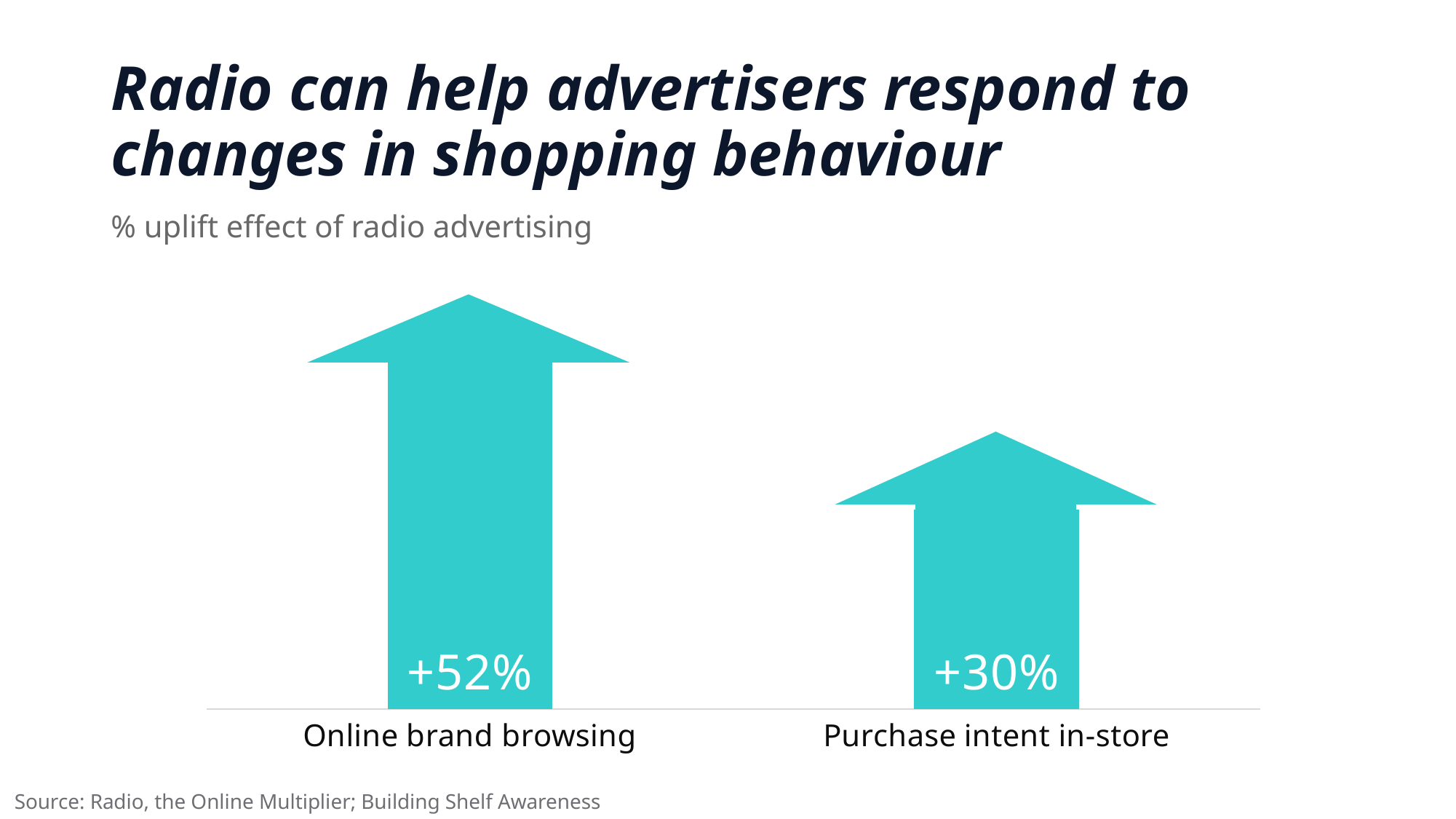
What is the subtitle describing what the chart measures? % uplift effect of radio advertising Which category shows the lowest uplift effect? Purchase intent in-store What is the % uplift effect of radio advertising for Purchase intent in-store? +30% What is the % uplift effect of radio advertising for Online brand browsing? +52% How many categories are shown in the chart? 2 What kind of chart is shown on the slide? Bar chart What colour are the bars in the chart? Teal What is the difference in uplift between Online brand browsing and Purchase intent in-store? 22 percentage points Which category shows the highest uplift effect? Online brand browsing Which is larger: the uplift for Online brand browsing or for Purchase intent in-store? Online brand browsing